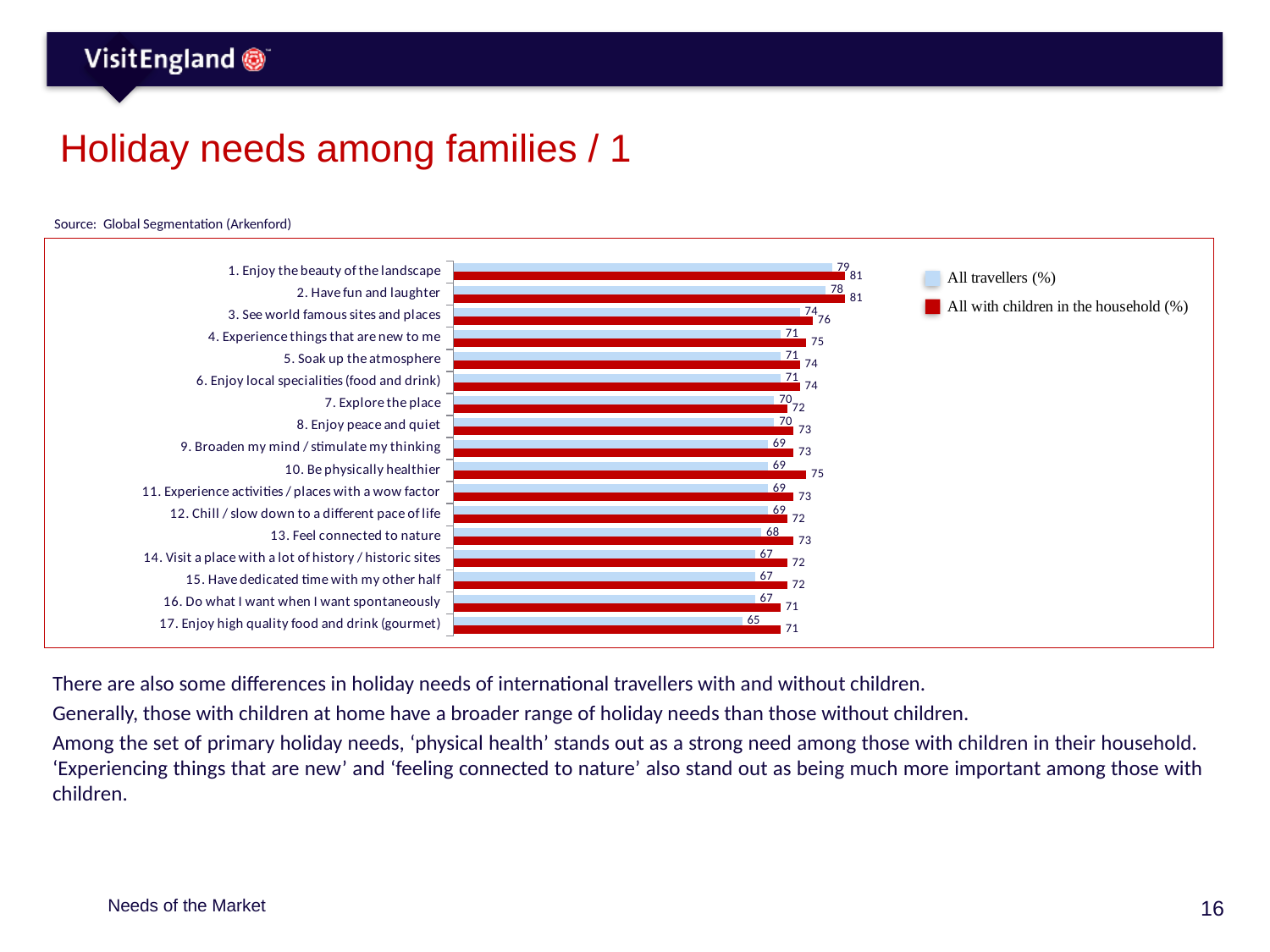
What is the value for 'All with children in the household (%)' for '4. Experience things that are new to me'? 75 How many series does the legend list? 2 What is the value for 'All with children in the household (%)' for '17. Enjoy high quality food and drink (gourmet)'? 71 How many categories are shown in the chart? 17 What is the value for 'All travellers (%)' for '10. Be physically healthier'? 69 Which colour represents 'All with children in the household (%)' in the chart? Red Which category has the highest value for 'All travellers (%)'? 1. Enjoy the beauty of the landscape What kind of chart is shown on the slide? Bar chart For '3. See world famous sites and places', which series has the larger value: 'All travellers (%)' or 'All with children in the household (%)'? All with children in the household (%) What is the difference between the 'All with children in the household (%)' value and the 'All travellers (%)' value for '10. Be physically healthier'? 6 Which category has the lowest value for 'All travellers (%)'? 17. Enjoy high quality food and drink (gourmet) What is the difference between the 'All with children in the household (%)' value and the 'All travellers (%)' value for '13. Feel connected to nature'? 5